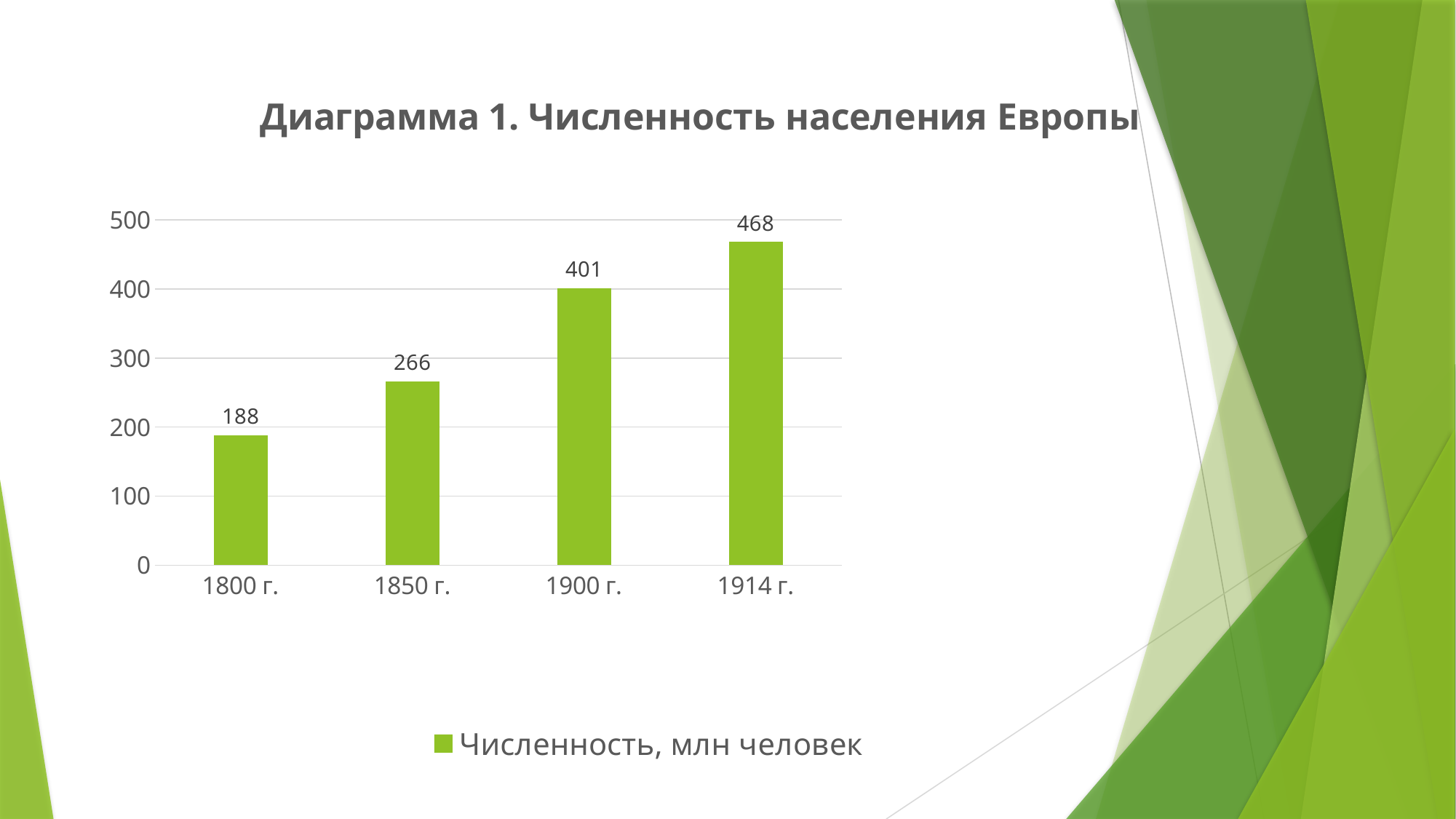
What is the value for 1850 г.? 266 What is the difference between the values for 1900 г. and 1850 г.? 135 Which is larger, the value for 1850 г. or the value for 1900 г.? 1900 г. How many categories are shown on the x axis? 4 Which year has the lowest value? 1800 г. Which year has the highest value? 1914 г. What is the difference between the values for 1914 г. and 1800 г.? 280 What is the value for 1914 г.? 468 Do the values rise or fall from 1800 г. to 1914 г.? rise What is the value for 1800 г.? 188 What is the value for 1900 г.? 401 What kind of chart is this? bar chart